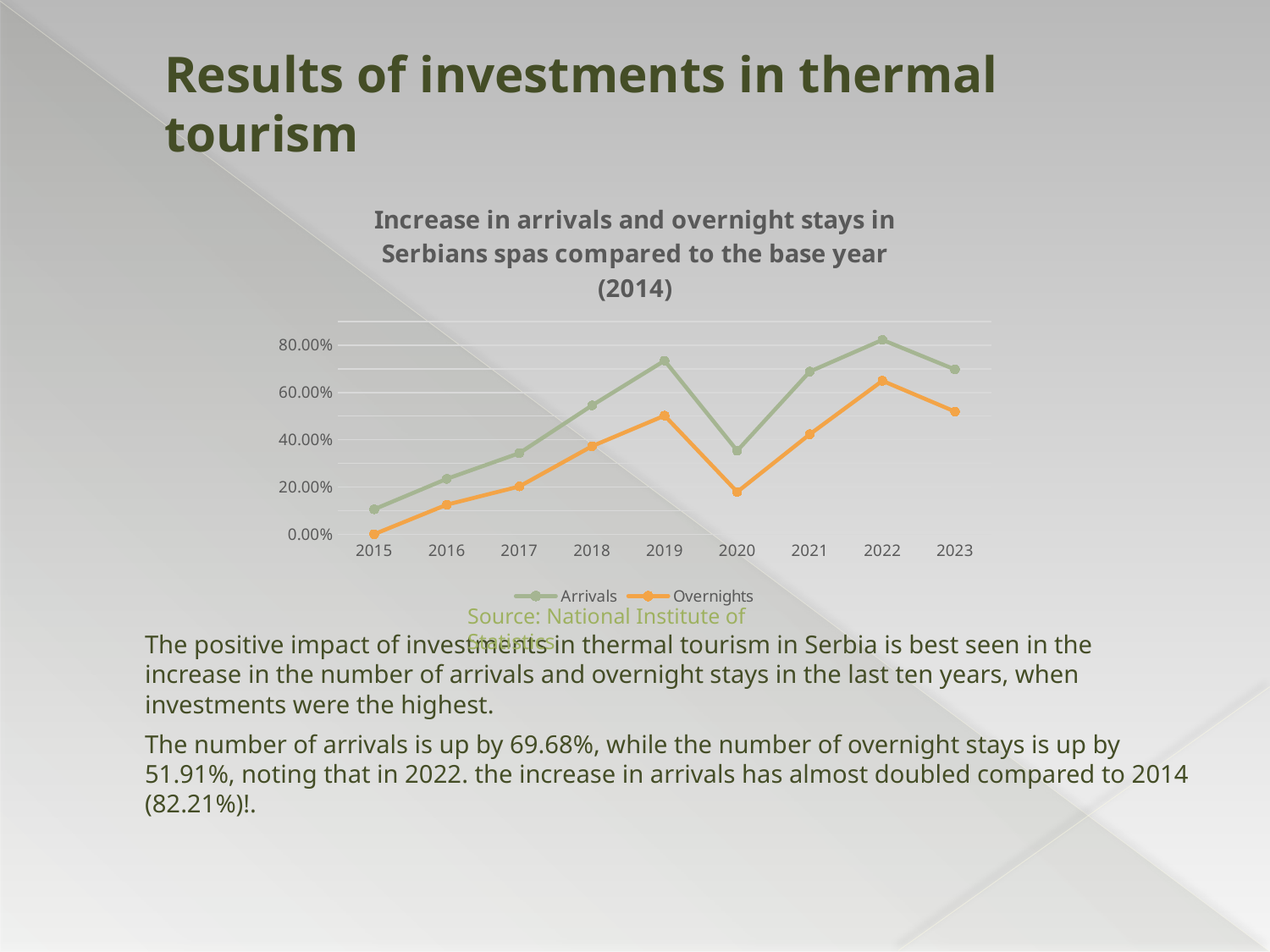
Is the value for Arrivals in 2020 greater or less than 40.00%? less Is the value for Overnights in 2022 greater or less than 60.00%? greater Do the Arrivals values rise or fall from 2015 to 2019? rise In 2019, which series has the larger value, Arrivals or Overnights? Arrivals How many years are plotted along the x axis of the chart? 9 Is the value for Arrivals in 2019 greater or less than 60.00%? greater What kind of chart is shown on the slide? line chart In which year does the Arrivals series reach its highest value? 2022 In which year does the Overnights series reach its lowest value? 2015 What are the two series named in the chart legend? Arrivals and Overnights How many series does the chart legend list? 2